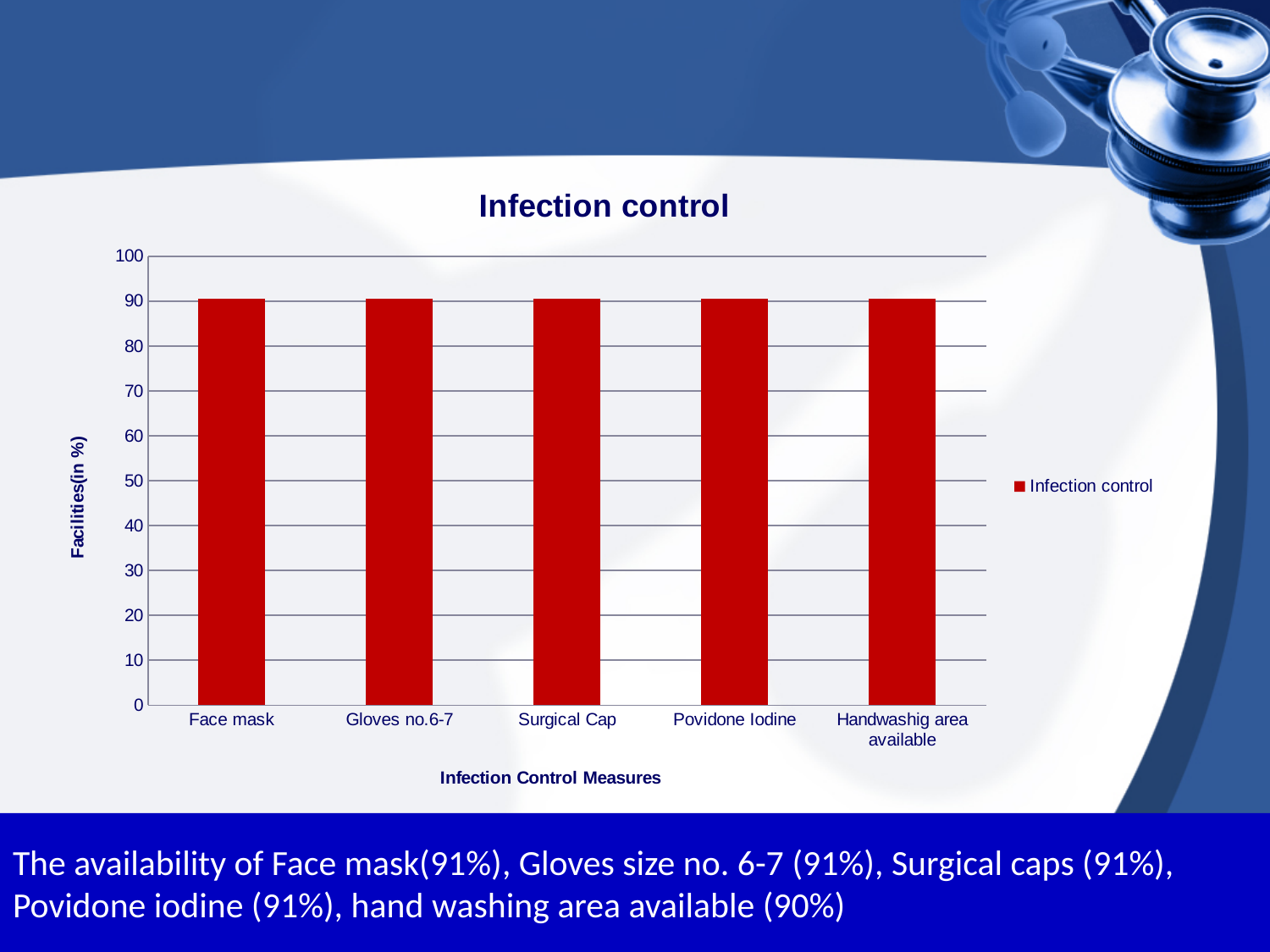
How many categories are shown on the x axis of the chart? 5 How many series does the chart's legend list? 1 What is the title of the chart? Infection control Is the value for Handwashig area available greater or less than 100? less Is the value for Povidone Iodine greater or less than 80? greater Is the value for Surgical Cap greater or less than 50? greater What kind of chart is shown on the slide? Bar chart What is the title of the vertical axis of the chart? Facilities(in %)